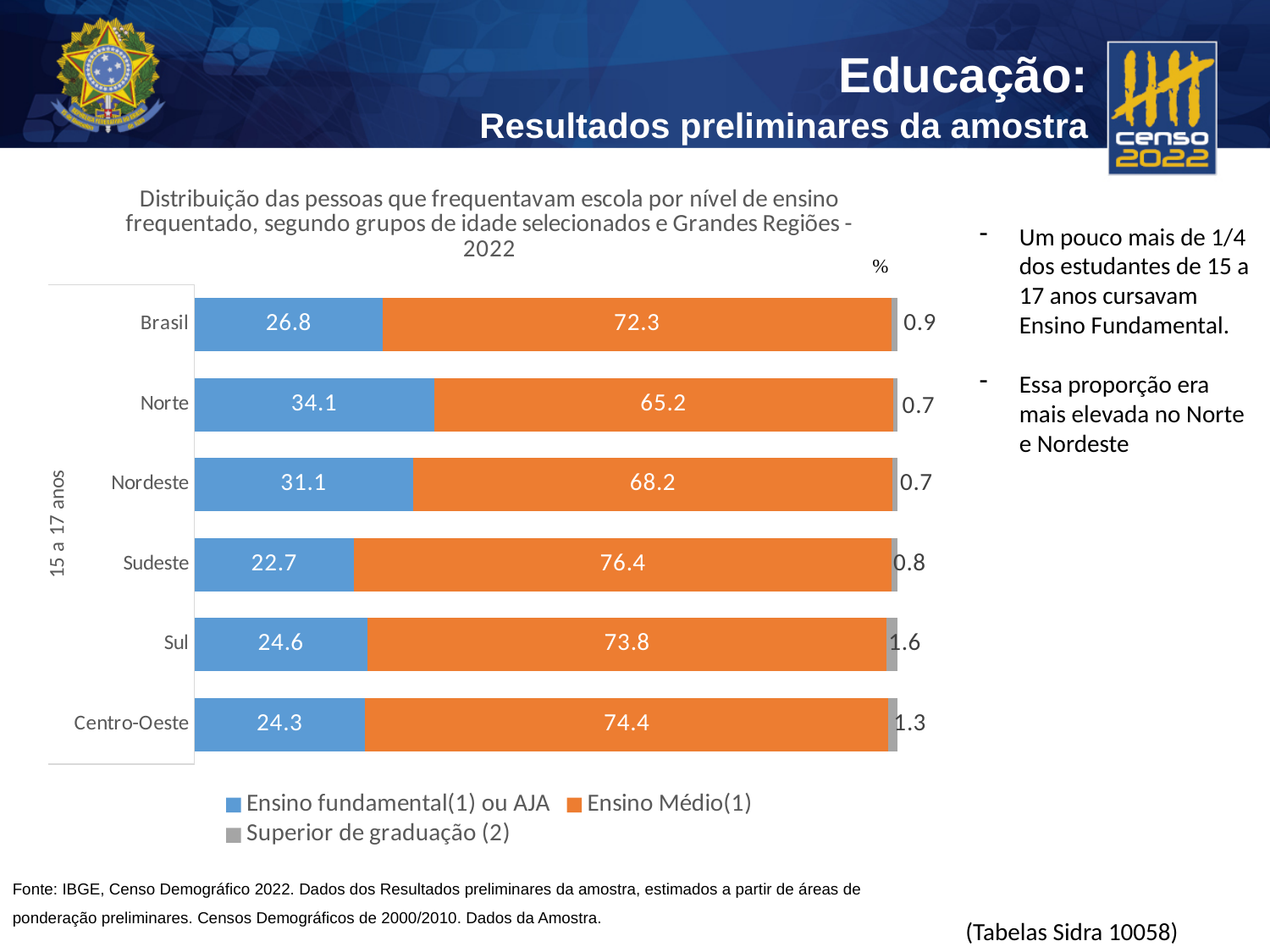
What is the total of the stacked bar for Brasil? 100.0 What is the value for Ensino Médio(1) for Sudeste? 76.4 How many series does the legend list? 3 Which is larger, the Ensino Médio(1) value for Sul or for Centro-Oeste? Centro-Oeste What age group label is shown on the vertical axis of the chart? 15 a 17 anos Which region has the highest value for Ensino fundamental(1) ou AJA? Norte What kind of chart is shown on the slide? Stacked bar chart What is the value for Superior de graduação (2) for Sul? 1.6 What is the difference between the Ensino fundamental(1) ou AJA values for Norte and Sudeste? 11.4 Which category has the lowest value for Ensino Médio(1)? Norte What is the value for Ensino fundamental(1) ou AJA for Norte? 34.1 How many categories (regions) are shown on the chart? 6